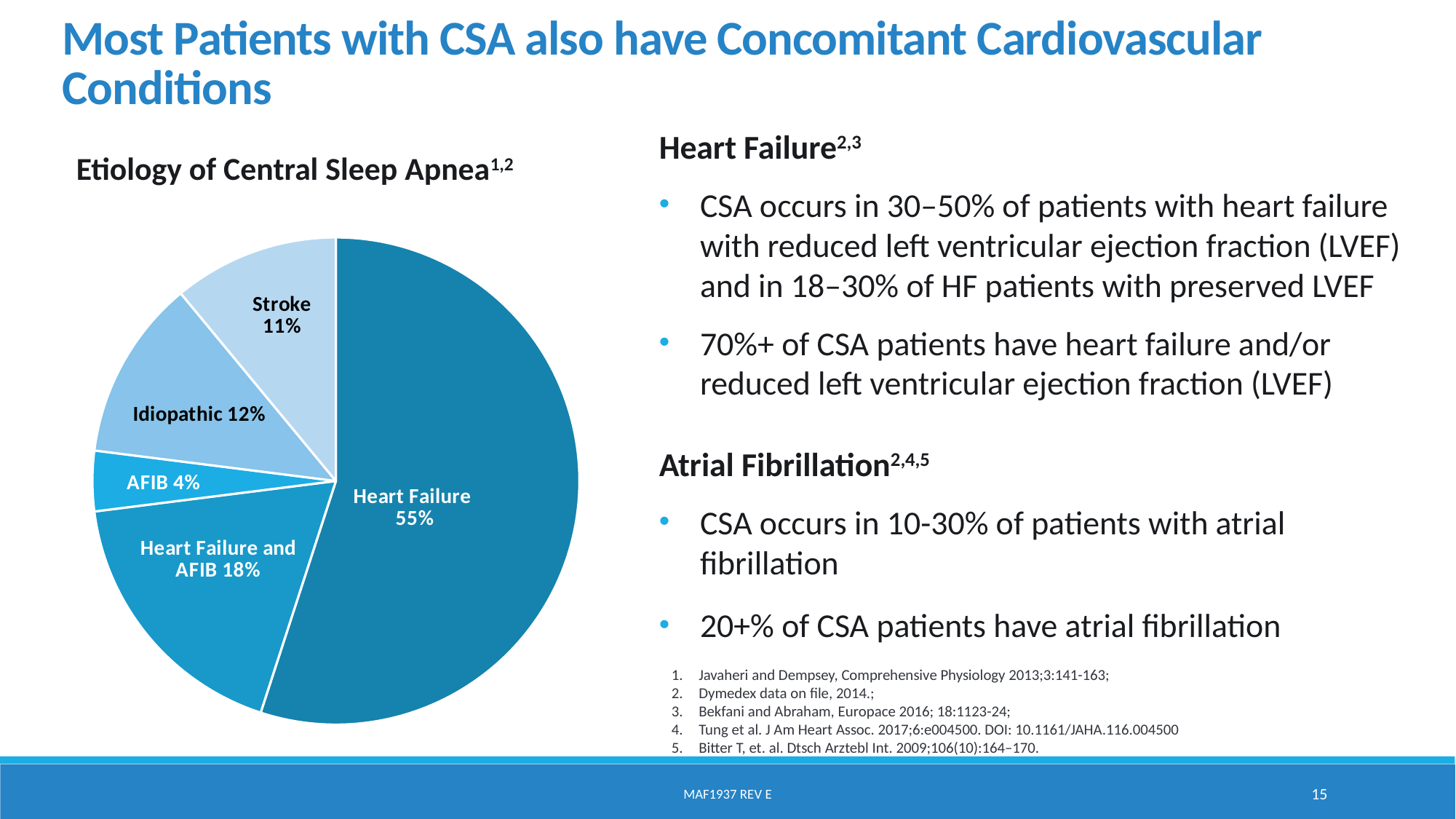
What share of the pie is Heart Failure and AFIB? 18% What is the difference in percentage points between the Heart Failure slice and the Heart Failure and AFIB slice? 37 Which slice of the pie is the smallest? AFIB What share of the pie is AFIB? 4% Which is larger, the Idiopathic slice or the Stroke slice? Idiopathic How many slices does the pie chart have? 5 What is the title of the chart? Etiology of Central Sleep Apnea What share of the pie is Heart Failure? 55% What share of the pie is Stroke? 11% What share of the pie is Idiopathic? 12% What kind of chart is shown on the slide? pie chart Which slice of the pie is the largest? Heart Failure